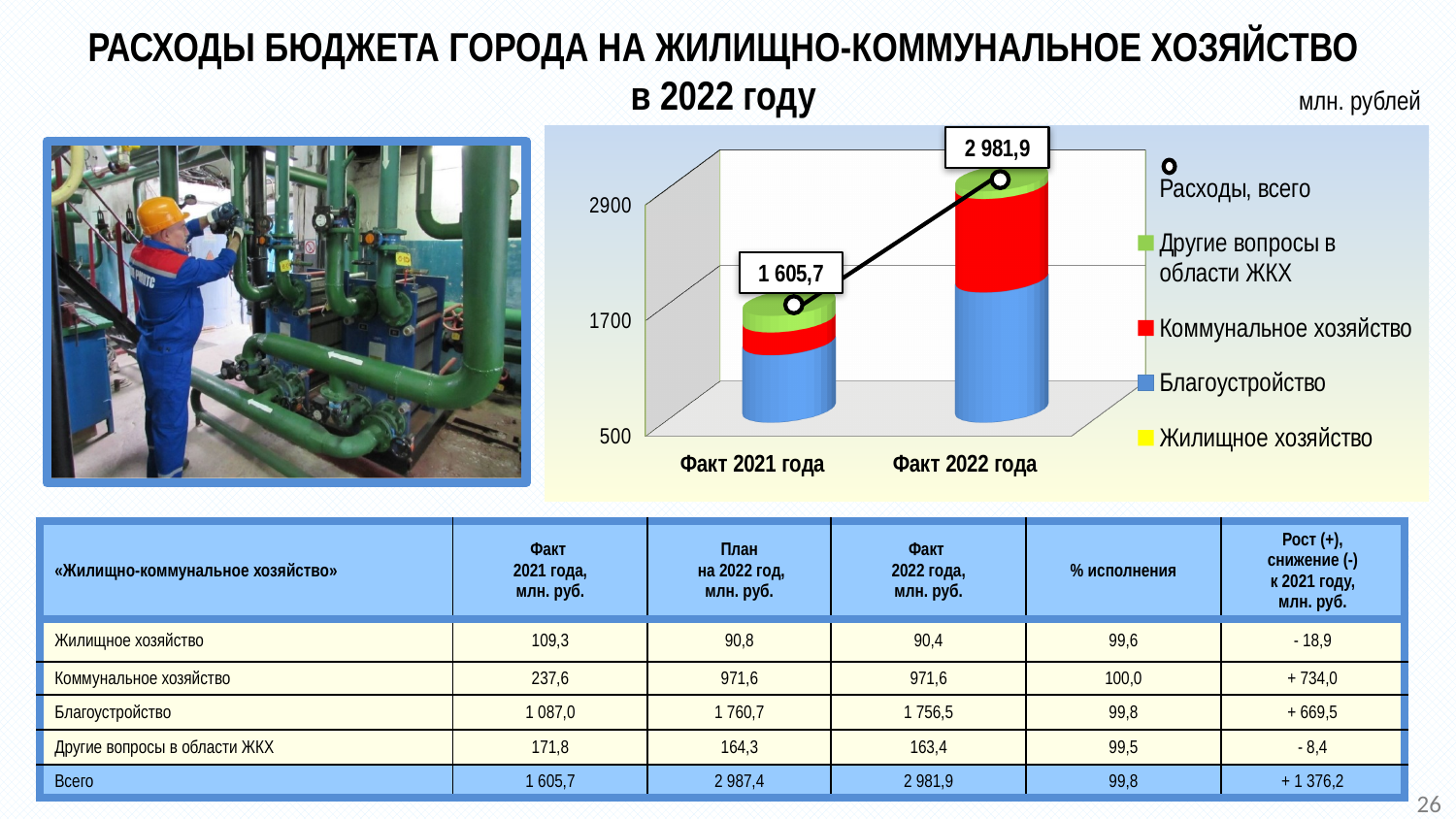
Which legend entry is shown in red? Коммунальное хозяйство How many categories are shown on the x axis of the chart? 2 What is the value of the 'Расходы, всего' data label for 'Факт 2021 года'? 1 605,7 What is the difference between the 'Расходы, всего' values for 'Факт 2022 года' and 'Факт 2021 года'? 1 376,2 What is the value of the 'Расходы, всего' data label for 'Факт 2022 года'? 2 981,9 How many entries does the chart legend list? 5 What kind of chart is shown on the slide? Stacked bar chart with a line Is the 'Расходы, всего' value for 'Факт 2022 года' greater or less than 2900? greater Is the 'Расходы, всего' value for 'Факт 2021 года' greater or less than 1700? less Does the 'Расходы, всего' line rise or fall from 'Факт 2021 года' to 'Факт 2022 года'? rise Which category has the higher total expenditure ('Расходы, всего'), 'Факт 2021 года' or 'Факт 2022 года'? Факт 2022 года Which category has the lower total expenditure ('Расходы, всего')? Факт 2021 года